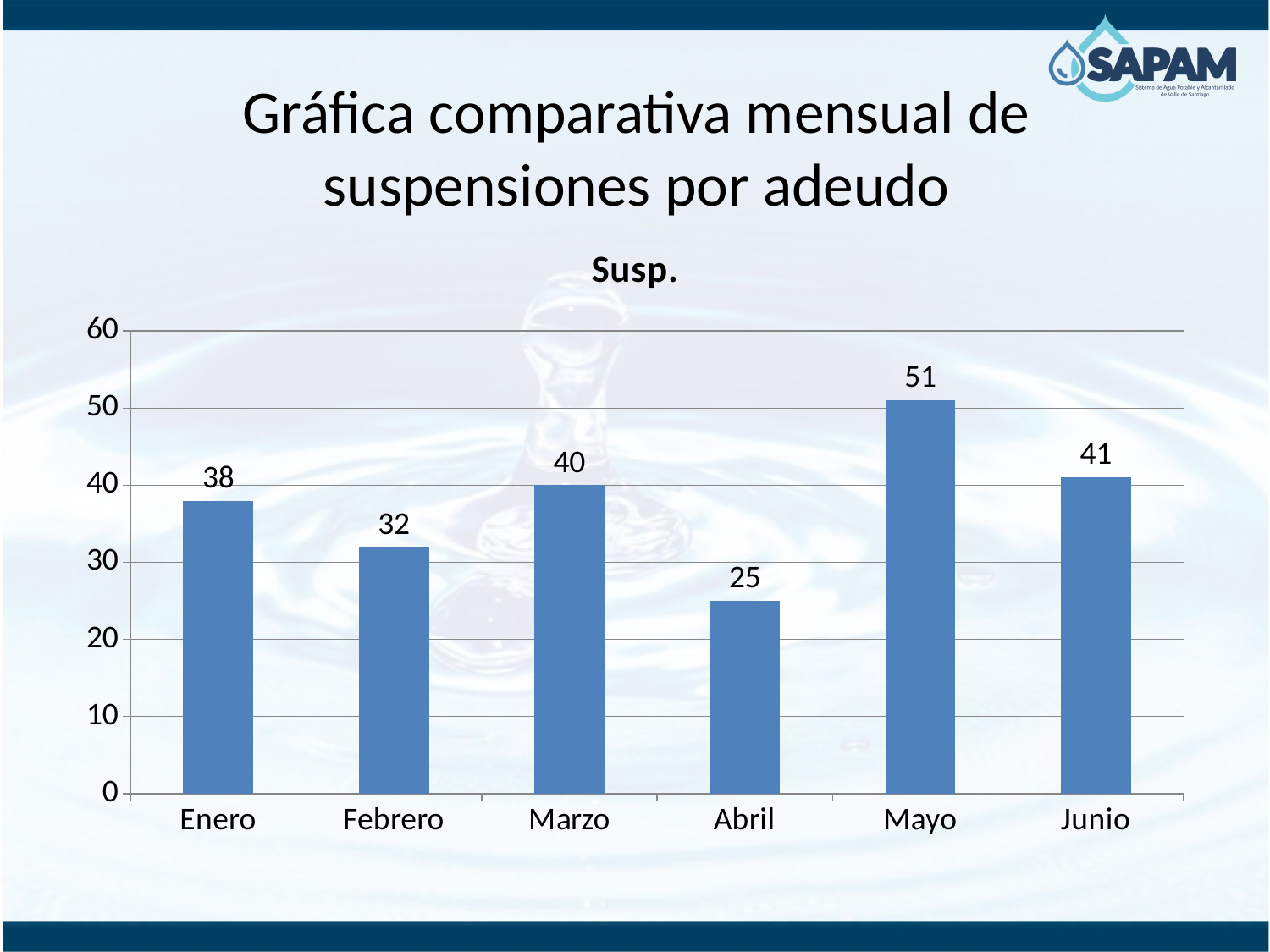
What is the value for Enero? 38 What kind of chart is shown on the slide? bar chart Which month has the lowest value? Abril Which month has the highest value? Mayo What is the value for Junio? 41 What is the title of the chart? Susp. Which is larger, the value for Enero or the value for Febrero? Enero How many months are shown on the x axis? 6 What is the difference between the values for Mayo and Abril? 26 What is the value for Abril? 25 What is the difference between the values for Marzo and Febrero? 8 Is the value for Mayo greater or less than 50? greater